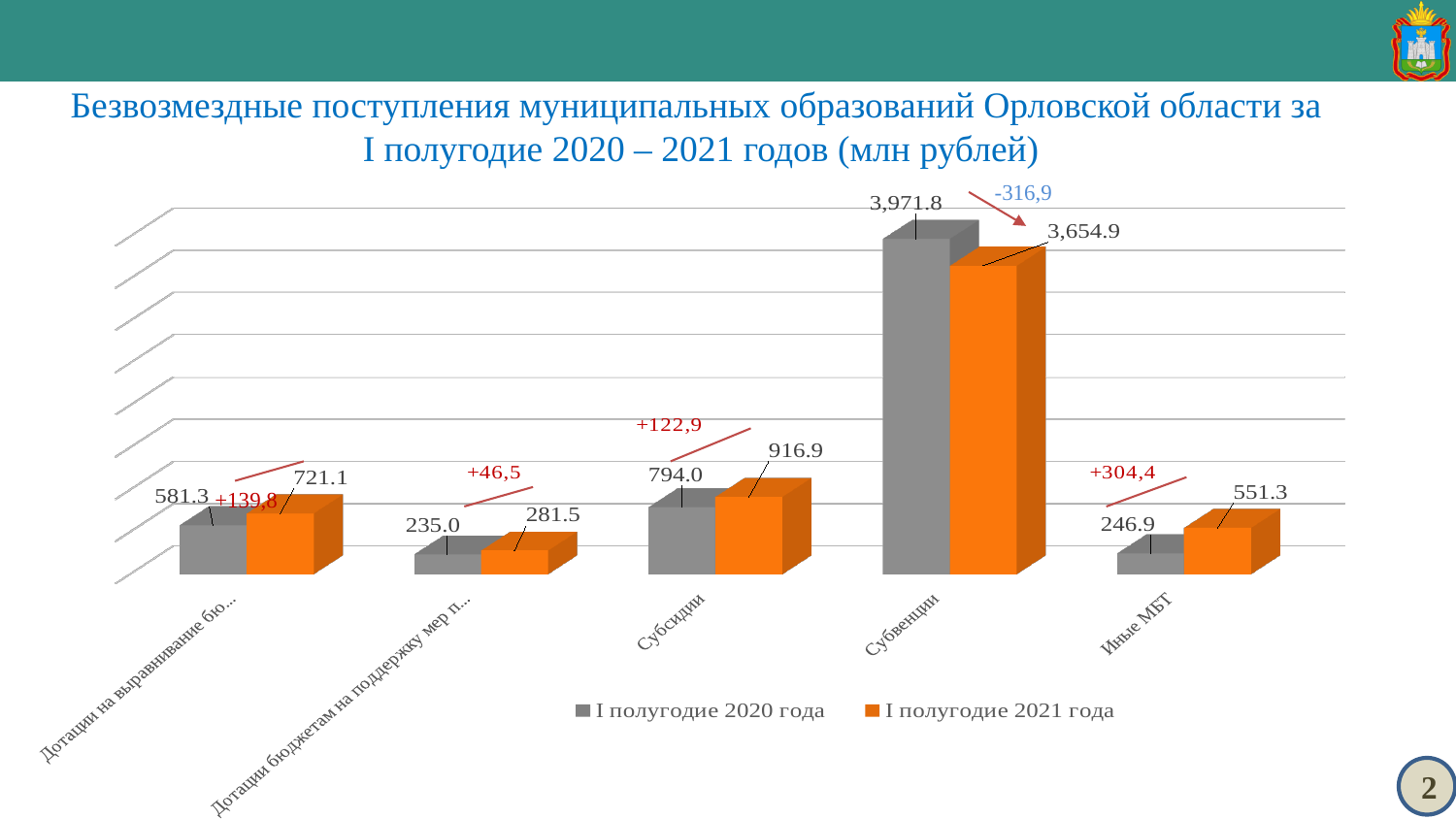
For Субсидии, which series has the larger value: I полугодие 2020 года or I полугодие 2021 года? I полугодие 2021 года What is the value for Субвенции in the series I полугодие 2020 года? 3,971.8 What is the difference between the 2021 and 2020 values for Иные МБТ? 304.4 Which category has the highest value in the series I полугодие 2021 года? Субвенции What is the difference between the 2020 and 2021 values for Субвенции? 316.9 What is the value for Иные МБТ in the series I полугодие 2020 года? 246.9 How many categories are shown on the x axis of the chart? 5 What is the value for Иные МБТ in the series I полугодие 2021 года? 551.3 How many series does the legend list? 2 What kind of chart is shown on the slide? Bar chart For Субвенции, which series has the larger value: I полугодие 2020 года or I полугодие 2021 года? I полугодие 2020 года What is the value for Субсидии in the series I полугодие 2021 года? 916.9